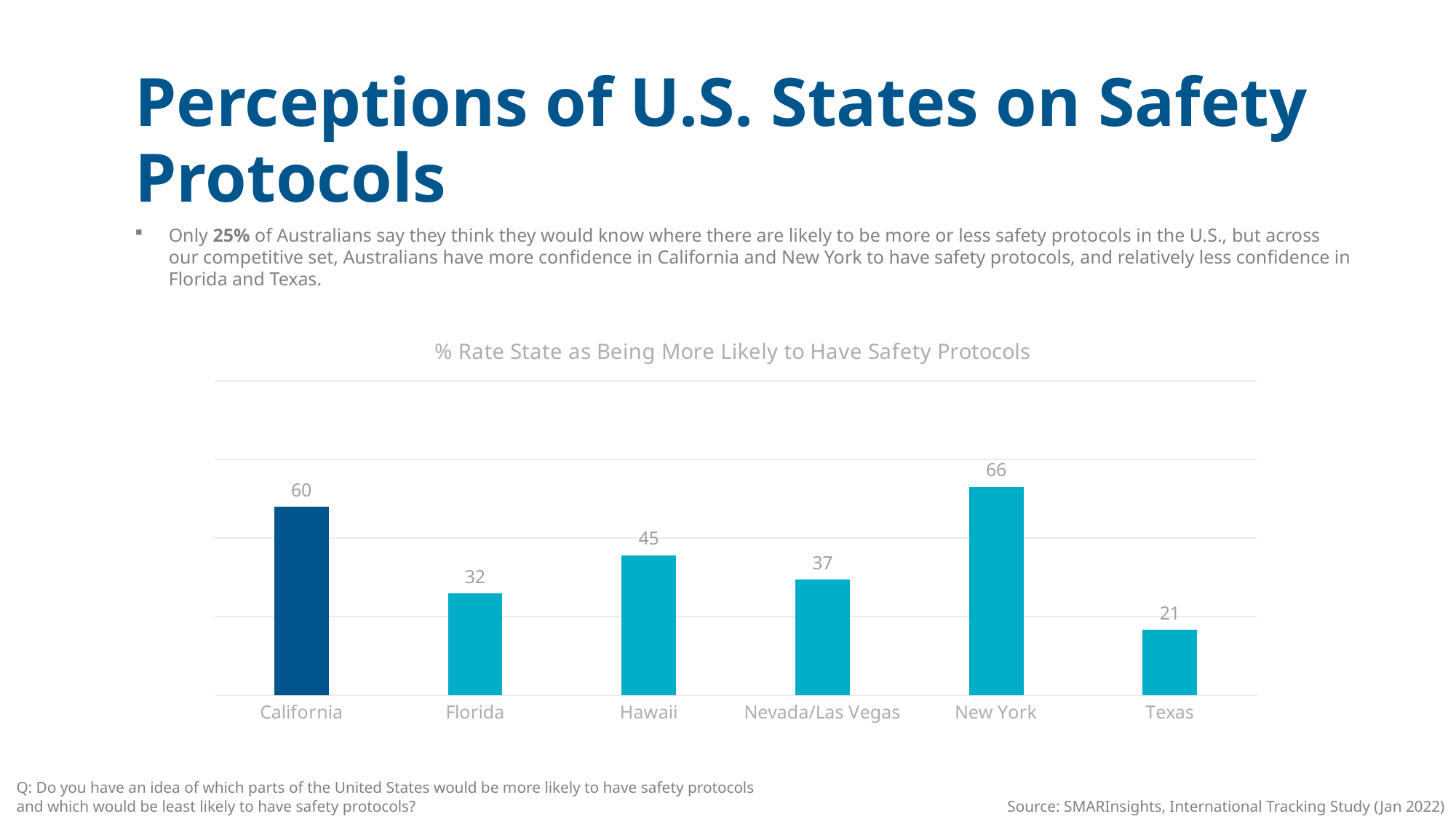
What is the difference between the values for New York and California? 6 What is the title of the chart? % Rate State as Being More Likely to Have Safety Protocols Which has a larger value, Florida or Nevada/Las Vegas? Nevada/Las Vegas What is the value for Nevada/Las Vegas? 37 Which bar is shown in a darker blue colour than the others? California What is the value for California? 60 What is the value for Texas? 21 How many states are shown in the chart? 6 Which state has the lowest value? Texas What is the difference between the values for Hawaii and Florida? 13 Which state has the highest value? New York What kind of chart is shown on the slide? Bar chart